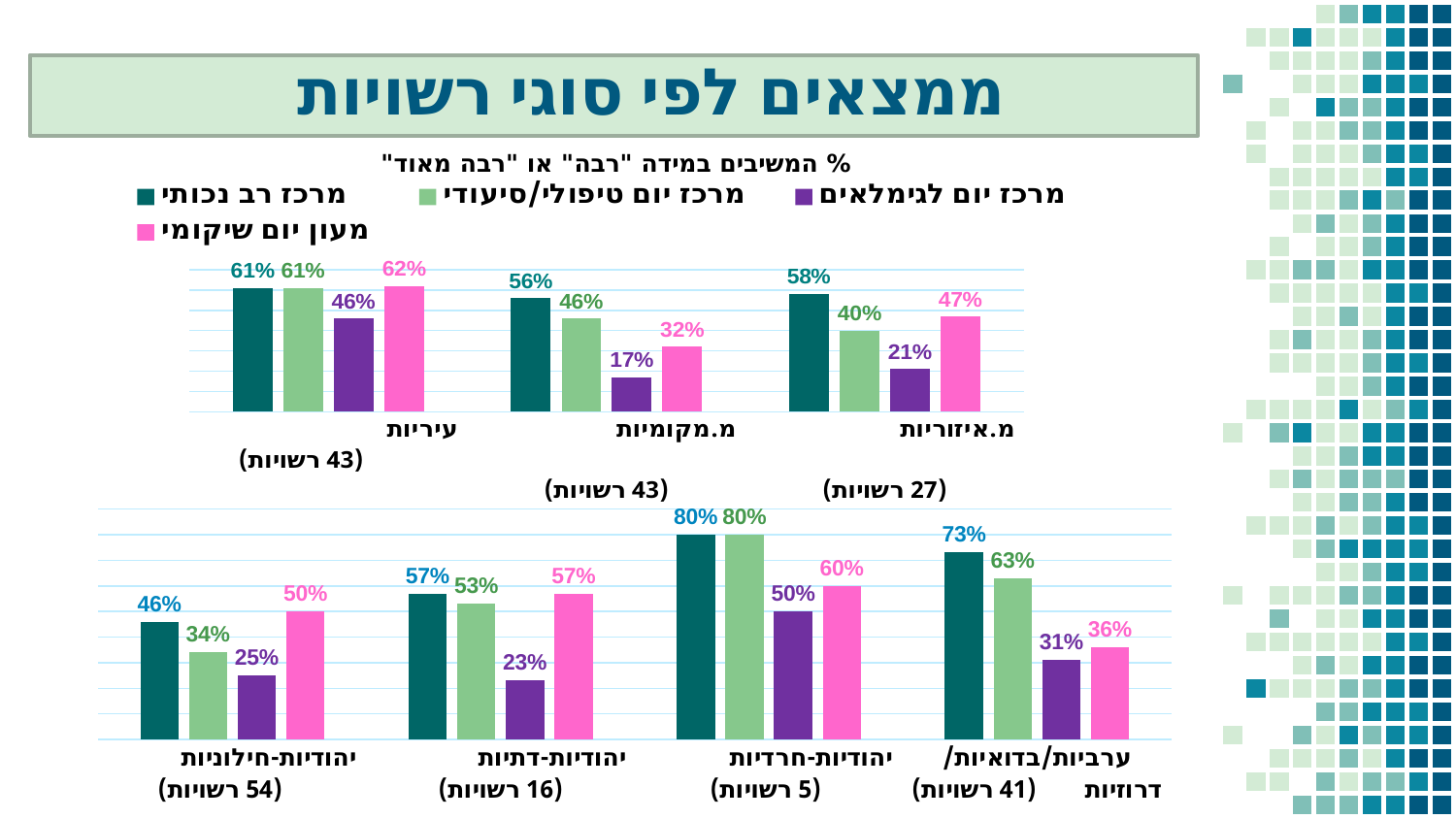
In the bottom chart, how many authorities are noted for the יהודיות-חרדיות category? 5 רשויות In the bottom chart, what is the value for מרכז יום טיפולי/סיעודי in the ערביות/בדואיות/דרוזיות category? 63% In the bottom chart, which category has the highest value for מרכז רב נכותי? יהודיות-חרדיות In the top chart, what is the value for מעון יום שיקומי in the מ.איזוריות category? 47% What kind of chart is the top chart? bar chart In the bottom chart, what is the difference between the מרכז רב נכותי value and the מרכז יום לגימלאים value in the יהודיות-דתיות category? 34% In the top chart, which is larger in the עיריות category: מרכז יום לגימלאים or מעון יום שיקומי? מעון יום שיקומי In the bottom chart, which is larger in the יהודיות-חילוניות category: מרכז רב נכותי or מרכז יום טיפולי/סיעודי? מרכז רב נכותי In the top chart, which category has the lowest value for מרכז יום לגימלאים? מ.מקומיות In the top chart, what is the value for מרכז יום לגימלאים in the מ.מקומיות category? 17% How many categories are shown in the bottom chart? 4 How many series does the legend list? 4